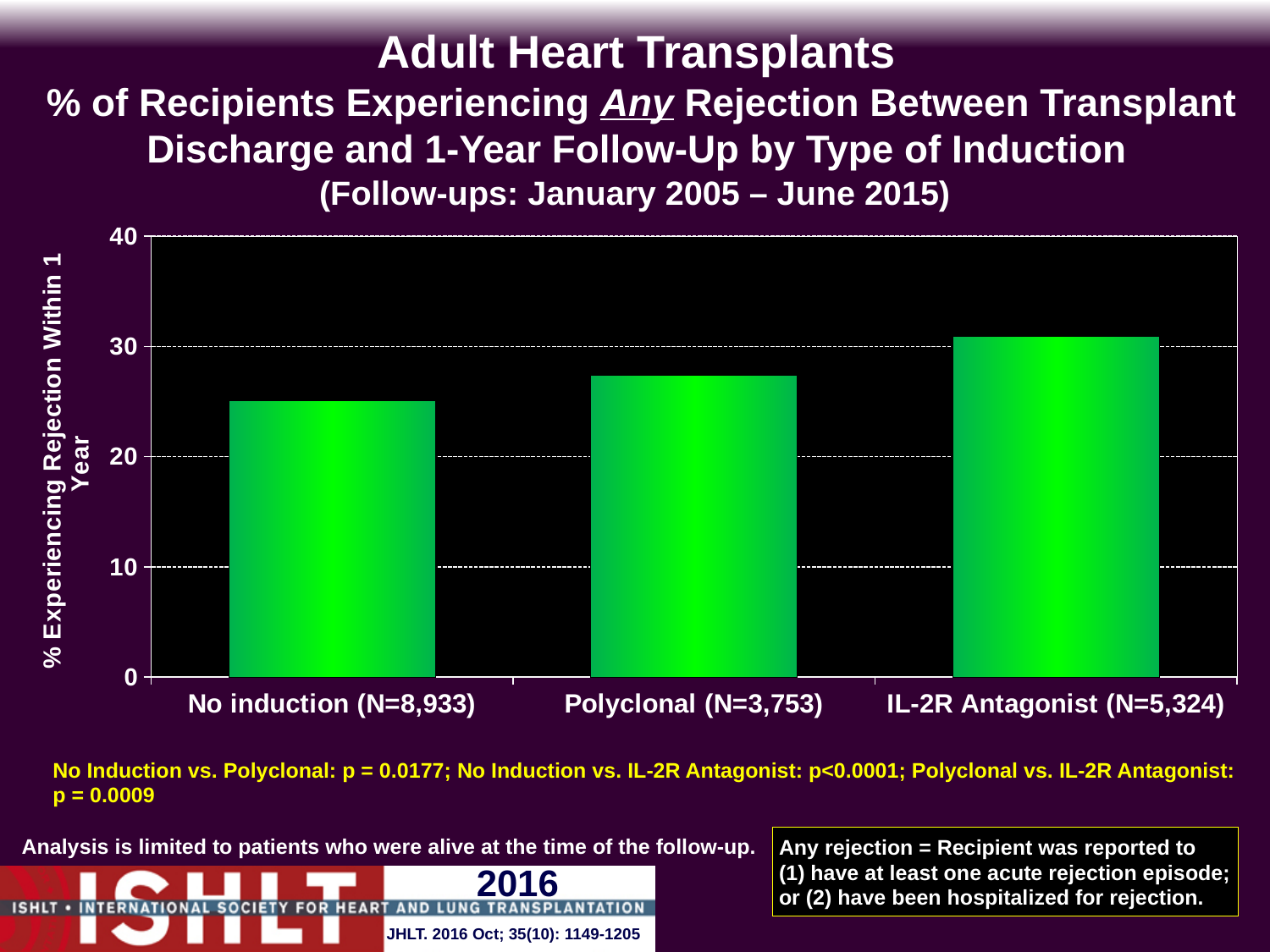
Is the value for No induction greater or less than 30? less What is the N shown for the Polyclonal category? 3,753 How many induction-type categories are plotted on the chart? 3 Is the value for IL-2R Antagonist greater or less than 30? greater Which induction type has the lowest % experiencing rejection within 1 year? No induction (N=8,933) What is the label of the y axis? % Experiencing Rejection Within 1 Year Which induction type has the highest % experiencing rejection within 1 year? IL-2R Antagonist (N=5,324) Is the value for No induction greater or less than 20? greater What kind of chart is shown on the slide? bar chart Do the bar values rise or fall moving from left to right across the categories? rise Which has a higher % experiencing rejection: No induction or Polyclonal? Polyclonal